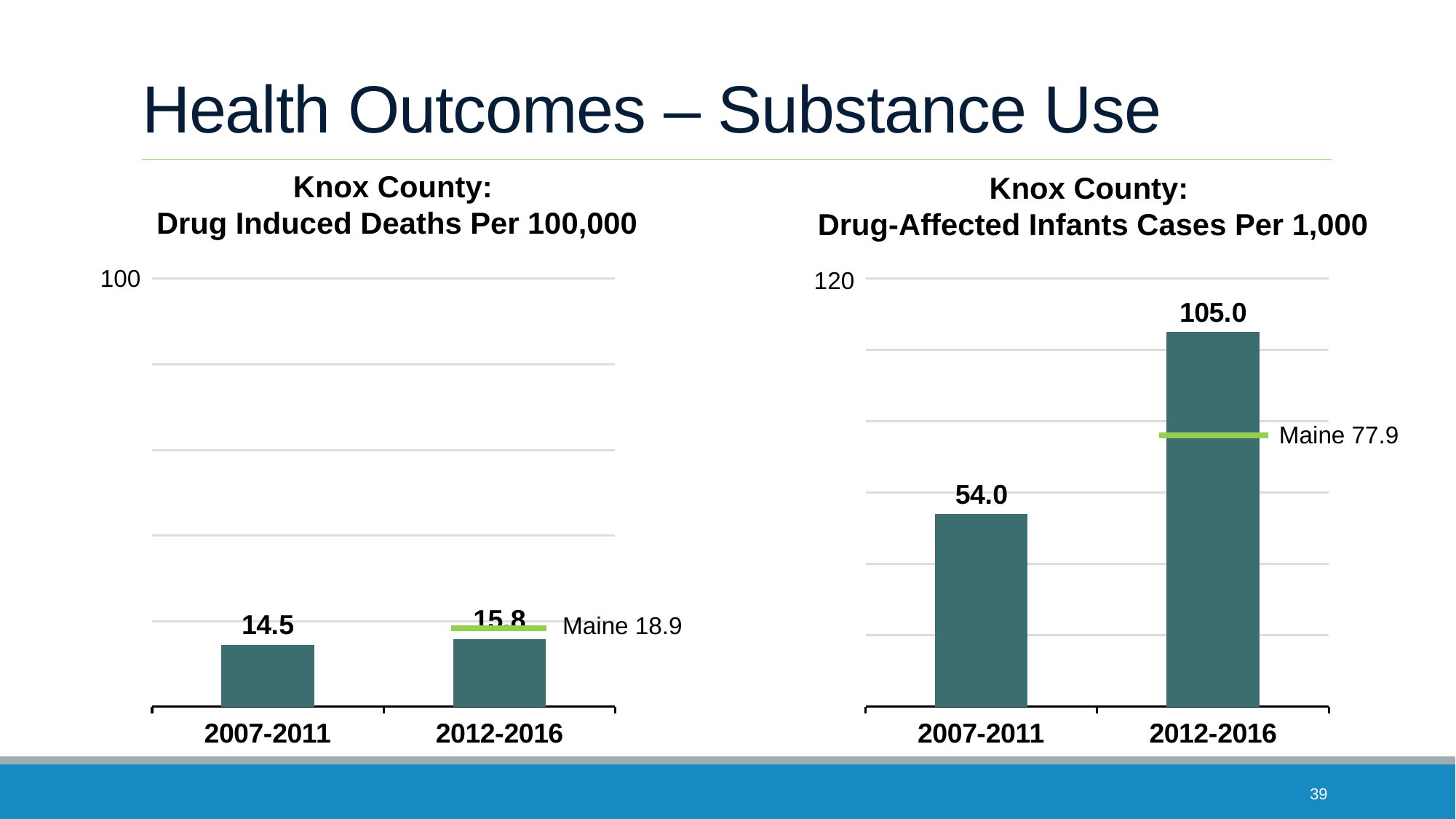
How many time periods are shown in the Drug-Affected Infants Cases Per 1,000 chart? 2 In the Drug-Affected Infants Cases Per 1,000 chart, what is the value for 2007-2011? 54.0 In the Drug Induced Deaths Per 100,000 chart, what is the value for 2007-2011? 14.5 In the Drug-Affected Infants Cases Per 1,000 chart, which period has the higher value? 2012-2016 In the Drug Induced Deaths Per 100,000 chart, what is the Maine value shown by the green line? 18.9 In the Drug Induced Deaths Per 100,000 chart, what is the value for 2012-2016? 15.8 In the Drug-Affected Infants Cases Per 1,000 chart, what is the difference between the 2012-2016 and 2007-2011 values? 51.0 In the Drug-Affected Infants Cases Per 1,000 chart, what is the Maine value shown by the green line? 77.9 In the Drug-Affected Infants Cases Per 1,000 chart, what is the value for 2012-2016? 105.0 What type of chart is the Drug Induced Deaths Per 100,000 chart? bar chart In the Drug Induced Deaths Per 100,000 chart, what is the difference between the 2012-2016 and 2007-2011 values? 1.3 In the Drug Induced Deaths Per 100,000 chart, do the values rise or fall from 2007-2011 to 2012-2016? rise